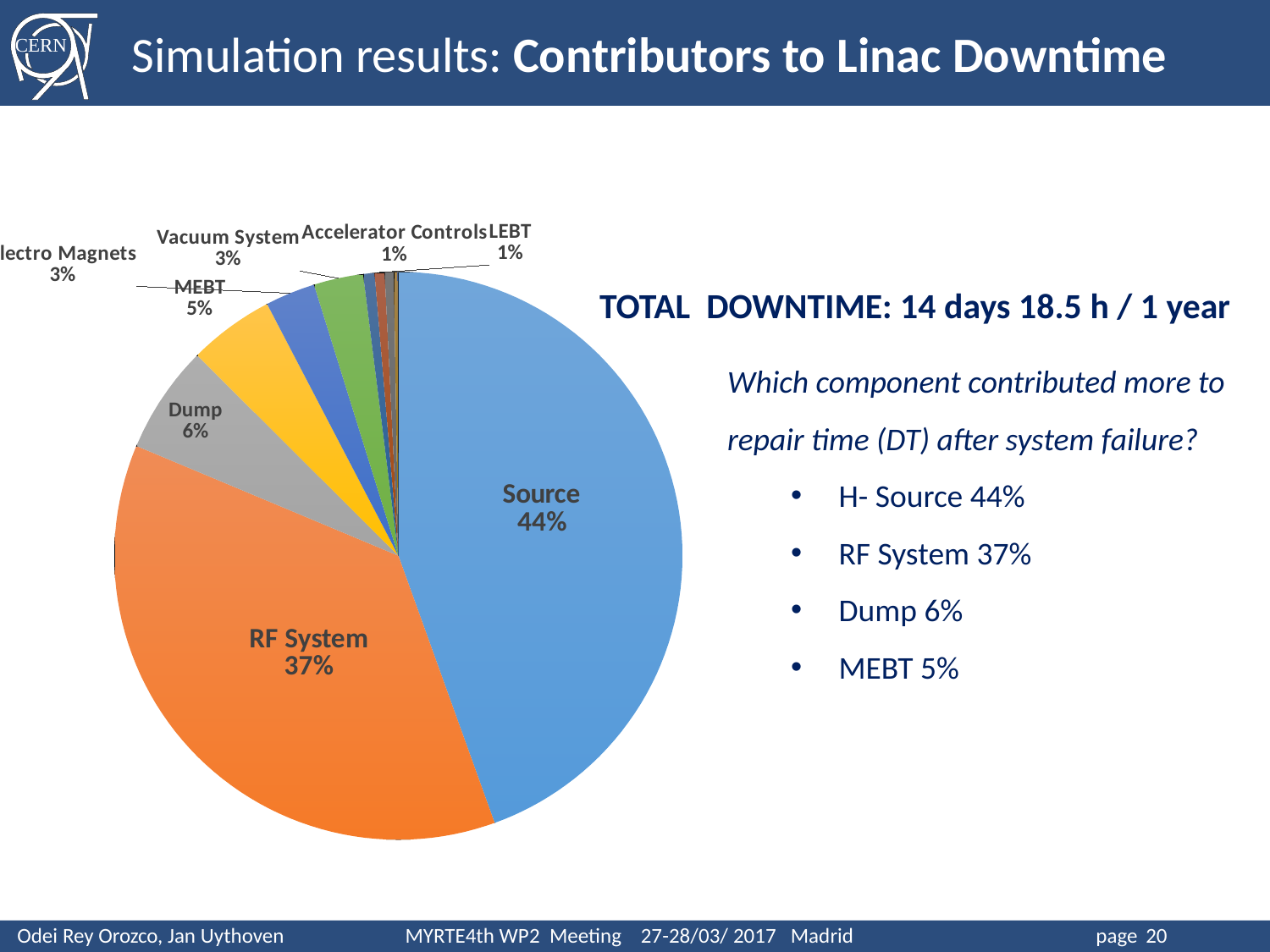
What colour is the Source slice in the pie chart? Blue What percentage does MEBT contribute to downtime? 5% What is the value shown for Vacuum System? 3% What type of chart is shown on the slide? Pie chart Which component is the largest contributor to Linac downtime in the pie chart? Source By how many percentage points does the Source share exceed the RF System share? 7% What share of Linac downtime does the Source contribute in the pie chart? 44% What is the value shown for Dump in the pie chart? 6% What is the difference between the Dump share and the MEBT share? 1% Which contributes more to downtime, Dump or MEBT? Dump What percentage is shown for LEBT? 1% What percentage of downtime is attributed to the RF System? 37%